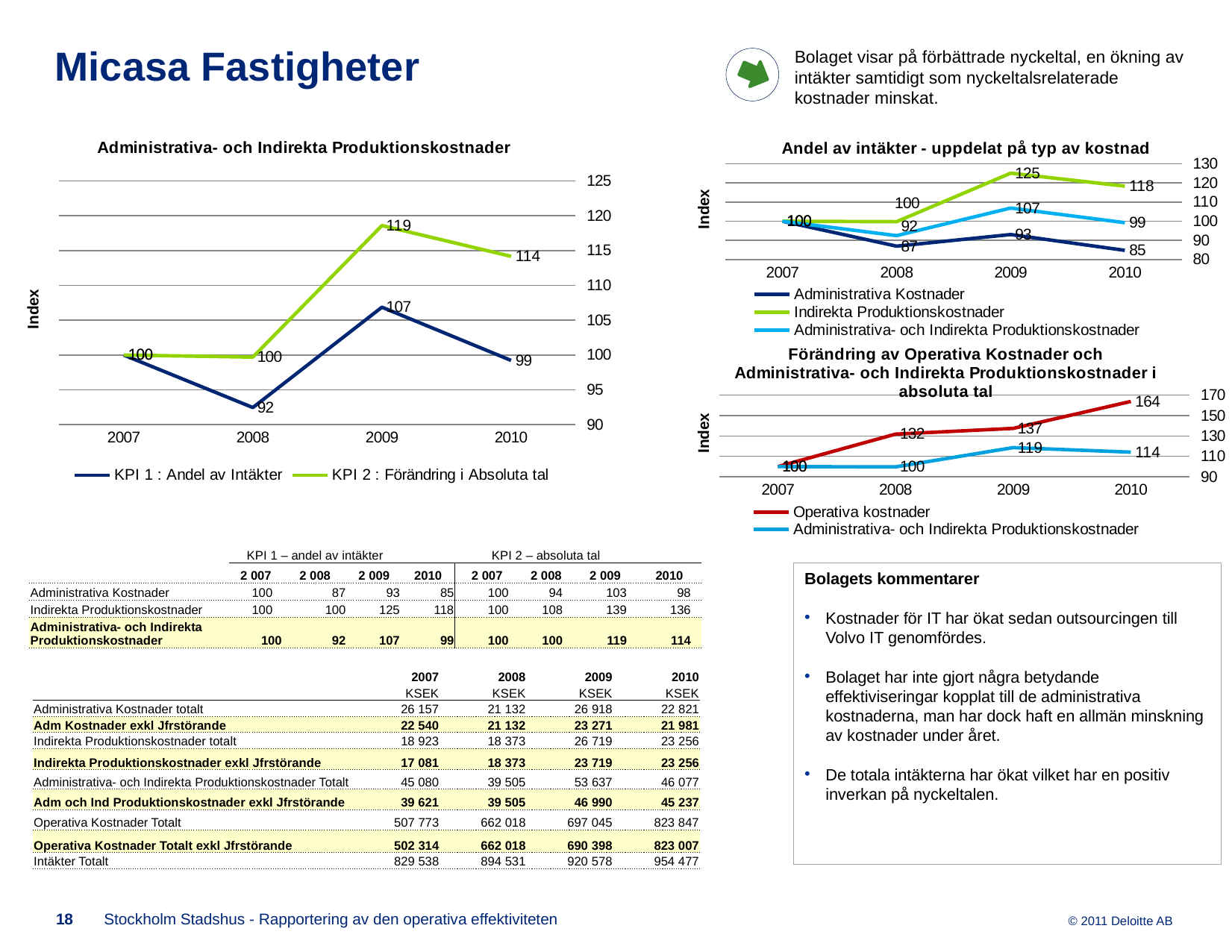
In the chart titled "Administrativa- och Indirekta Produktionskostnader", what is the difference between KPI 2 and KPI 1 in 2010? 15 In the chart titled "Andel av intäkter - uppdelat på typ av kostnad", which series has the highest value in 2009? Indirekta Produktionskostnader In the chart titled "Andel av intäkter - uppdelat på typ av kostnad", what is the value of Administrativa Kostnader in 2010? 85 In the chart titled "Administrativa- och Indirekta Produktionskostnader", in which year does KPI 1 : Andel av Intäkter reach its highest value? 2009 In the chart titled "Förändring av Operativa Kostnader och Administrativa- och Indirekta Produktionskostnader i absoluta tal", what is the difference between Operativa kostnader and Administrativa- och Indirekta Produktionskostnader in 2008? 32 In the chart titled "Administrativa- och Indirekta Produktionskostnader", what is the value of KPI 2 : Förändring i Absoluta tal in 2009? 119 In the chart titled "Administrativa- och Indirekta Produktionskostnader", what is the value of KPI 1 : Andel av Intäkter in 2008? 92 In the chart titled "Förändring av Operativa Kostnader och Administrativa- och Indirekta Produktionskostnader i absoluta tal", does Operativa kostnader rise or fall from 2007 to 2010? Rise In the chart titled "Administrativa- och Indirekta Produktionskostnader", how many series does the legend list? 2 In the chart titled "Förändring av Operativa Kostnader och Administrativa- och Indirekta Produktionskostnader i absoluta tal", what is the value of Operativa kostnader in 2010? 164 In the chart titled "Andel av intäkter - uppdelat på typ av kostnad", how many series does the legend list? 3 What type of chart is "Administrativa- och Indirekta Produktionskostnader"? Line chart